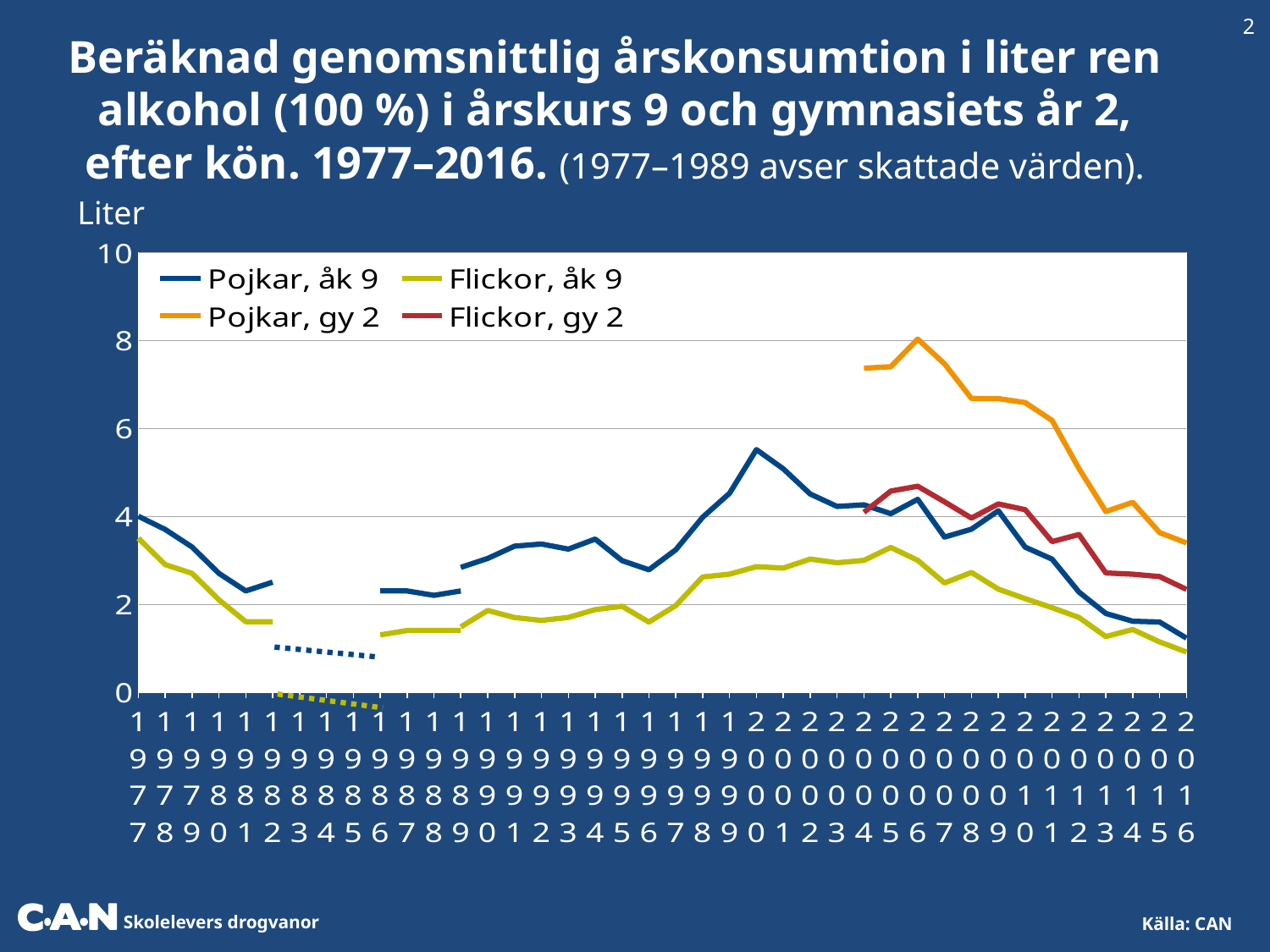
How many series does the legend list? 4 Is the value for Pojkar, gy 2 in 2006 greater or less than 6? greater What are the four series named in the legend? Pojkar, åk 9; Pojkar, gy 2; Flickor, åk 9; Flickor, gy 2 In 2016, which is larger: Pojkar, gy 2 or Flickor, gy 2? Pojkar, gy 2 In which year does the Pojkar, åk 9 line reach its peak? 2000 What unit label is shown above the y axis? Liter Does the Pojkar, gy 2 line rise or fall from 2006 to 2016? fall Is the value for Pojkar, åk 9 in 2000 greater or less than 4? greater What kind of chart is shown on the slide? line chart Is the value for Flickor, åk 9 in 2016 greater or less than 2? less Which series reaches the highest value anywhere on the chart? Pojkar, gy 2